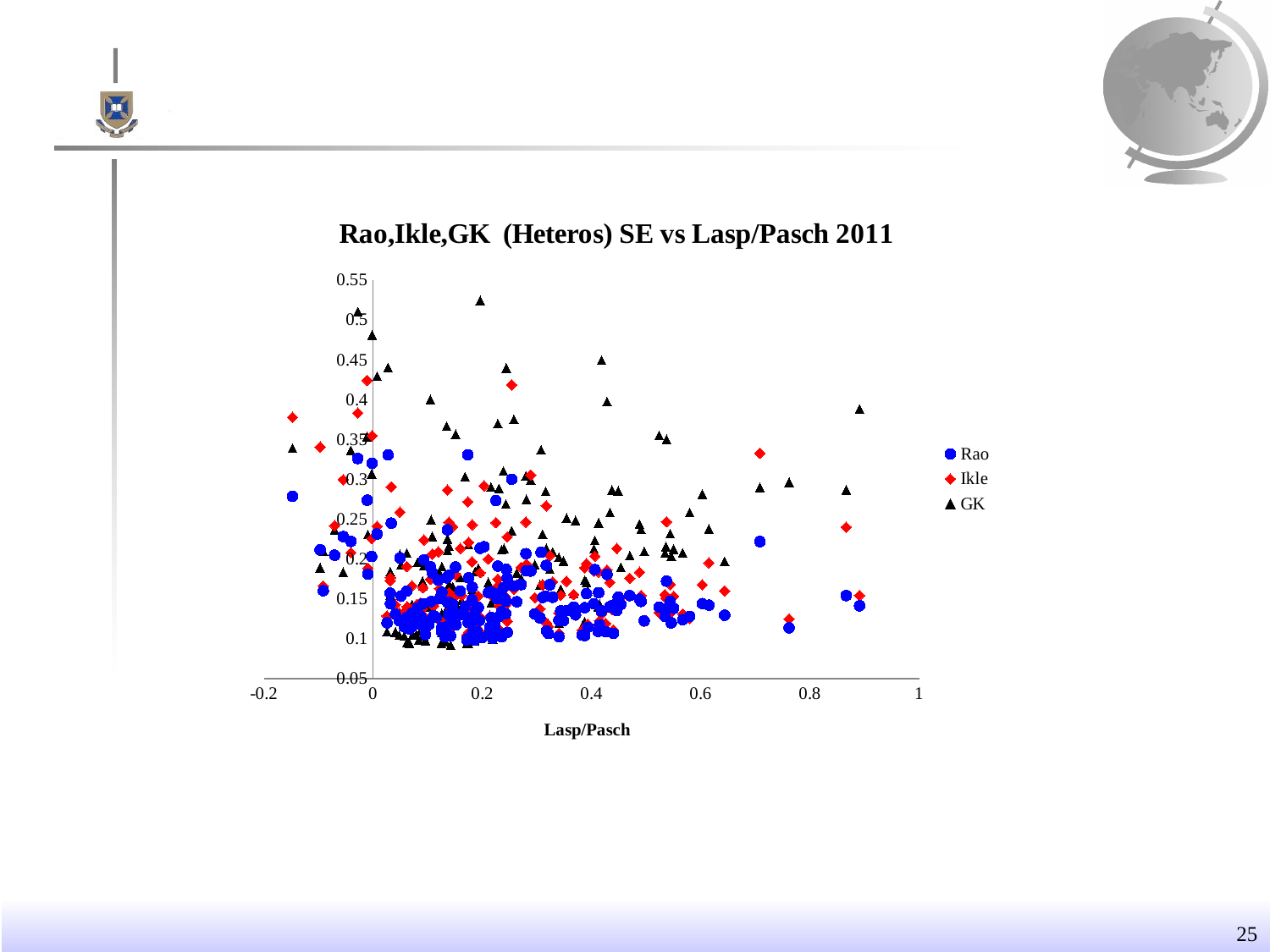
What is the label on the x axis of the chart? Lasp/Pasch What is the title of the chart? Rao,Ikle,GK (Heteros) SE vs Lasp/Pasch 2011 Which series has a higher maximum value, Rao or GK? GK What kind of chart is shown on the slide? Scatter chart Is the highest plotted value on the chart greater or less than 0.5? greater Is the highest Rao value greater or less than 0.4? less Is the highest GK value greater or less than 0.45? greater What is the highest value shown on the y axis of the chart? 0.55 How many series does the legend list? 3